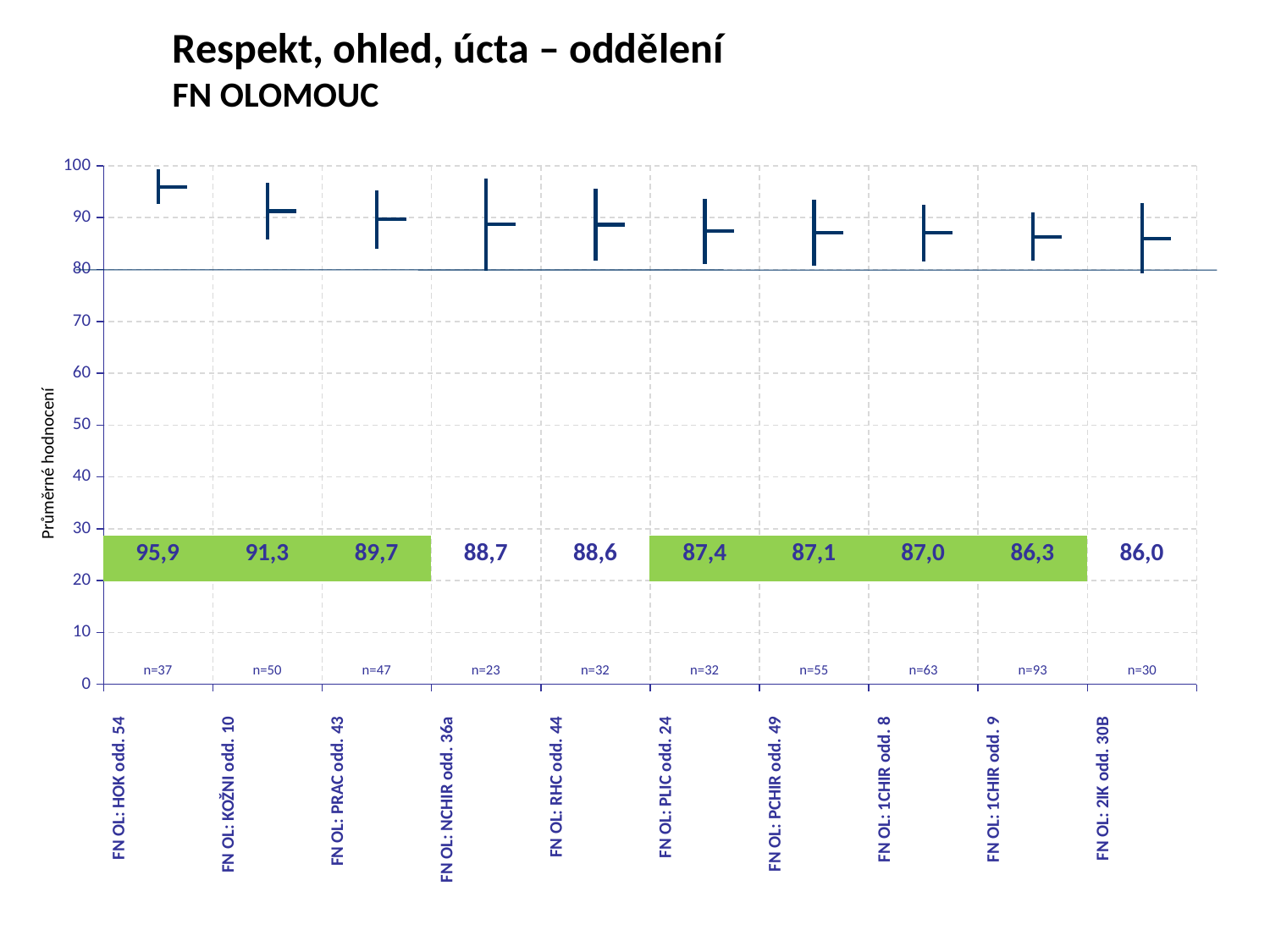
What is the average rating for FN OL: NCHIR odd. 36a? 88,7 Which has a higher average rating, FN OL: PRAC odd. 43 or FN OL: RHC odd. 44? FN OL: PRAC odd. 43 How many departments are shown on the chart? 10 Do the average ratings rise or fall from left to right along the x axis? fall Which department has the lowest average rating? FN OL: 2IK odd. 30B What is the sample size (n) shown for FN OL: PCHIR odd. 49? n=55 What is the average rating for FN OL: 1CHIR odd. 9? 86,3 What is the title of the chart? Respekt, ohled, úcta – oddělení Which department has the highest average rating? FN OL: HOK odd. 54 What is the label of the vertical axis? Průměrné hodnocení What is the difference between the average ratings of FN OL: HOK odd. 54 and FN OL: KOŽNI odd. 10? 4,6 What is the average rating for FN OL: HOK odd. 54? 95,9